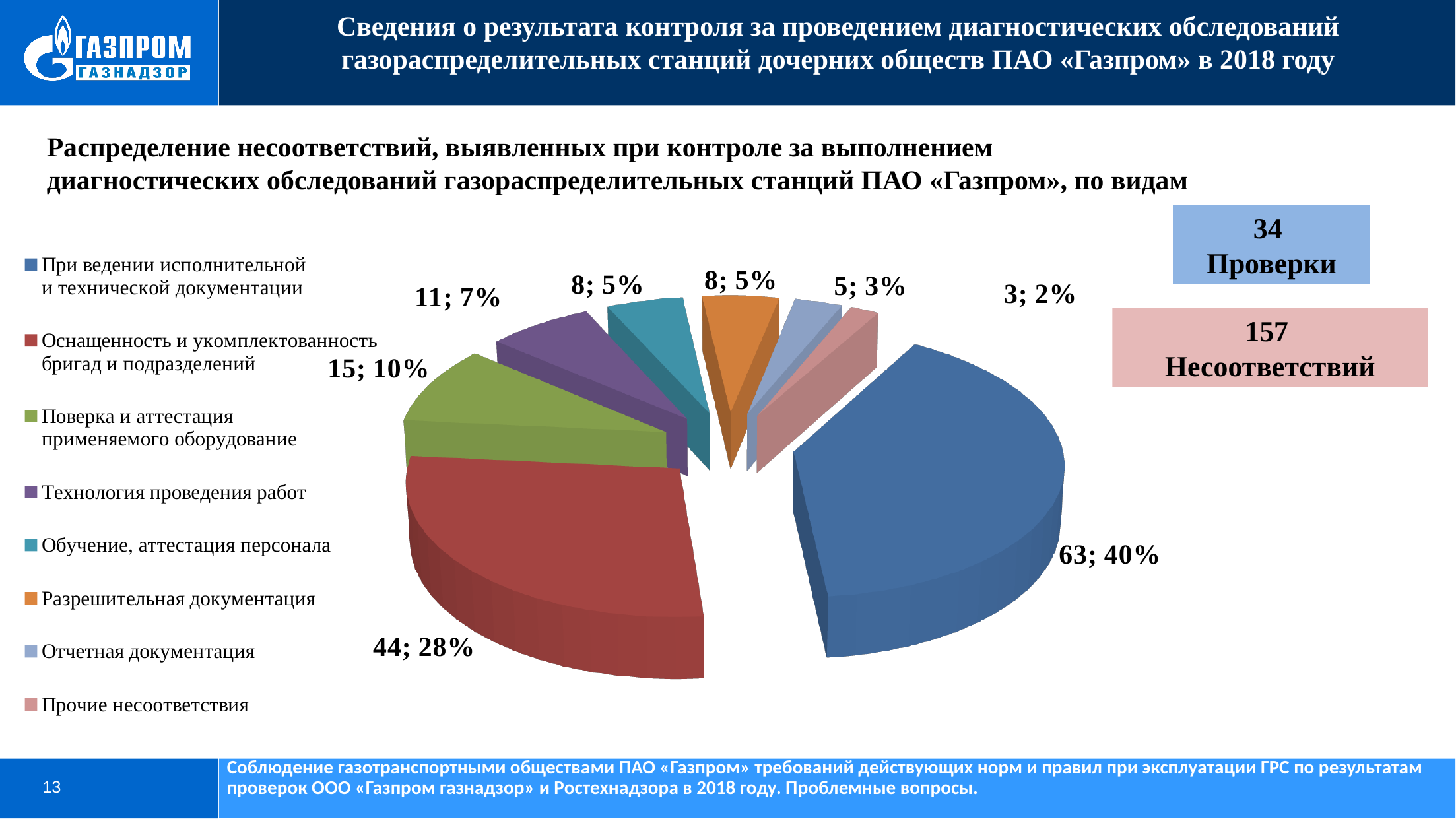
How many slices does the pie chart have? 8 Which is larger: the value for "Поверка и аттестация применяемого оборудование" or for "Технология проведения работ"? Поверка и аттестация применяемого оборудование What value and share are shown for the slice "Технология проведения работ"? 11; 7% What share of the pie does the slice "Отчетная документация" represent? 3% What kind of chart is shown on the slide? pie chart What value and share are shown for the slice "При ведении исполнительной и технической документации"? 63; 40% What total number of non-conformities (Несоответствий) is shown in the box to the right of the chart? 157 Which category has the smallest slice of the pie? Прочие несоответствия Which category has the largest slice of the pie? При ведении исполнительной и технической документации What value and share are shown for the slice "Поверка и аттестация применяемого оборудование"? 15; 10% What is the difference between the values for "При ведении исполнительной и технической документации" and "Оснащенность и укомплектованность бригад и подразделений"? 19 What value and share are shown for the slice "Оснащенность и укомплектованность бригад и подразделений"? 44; 28%